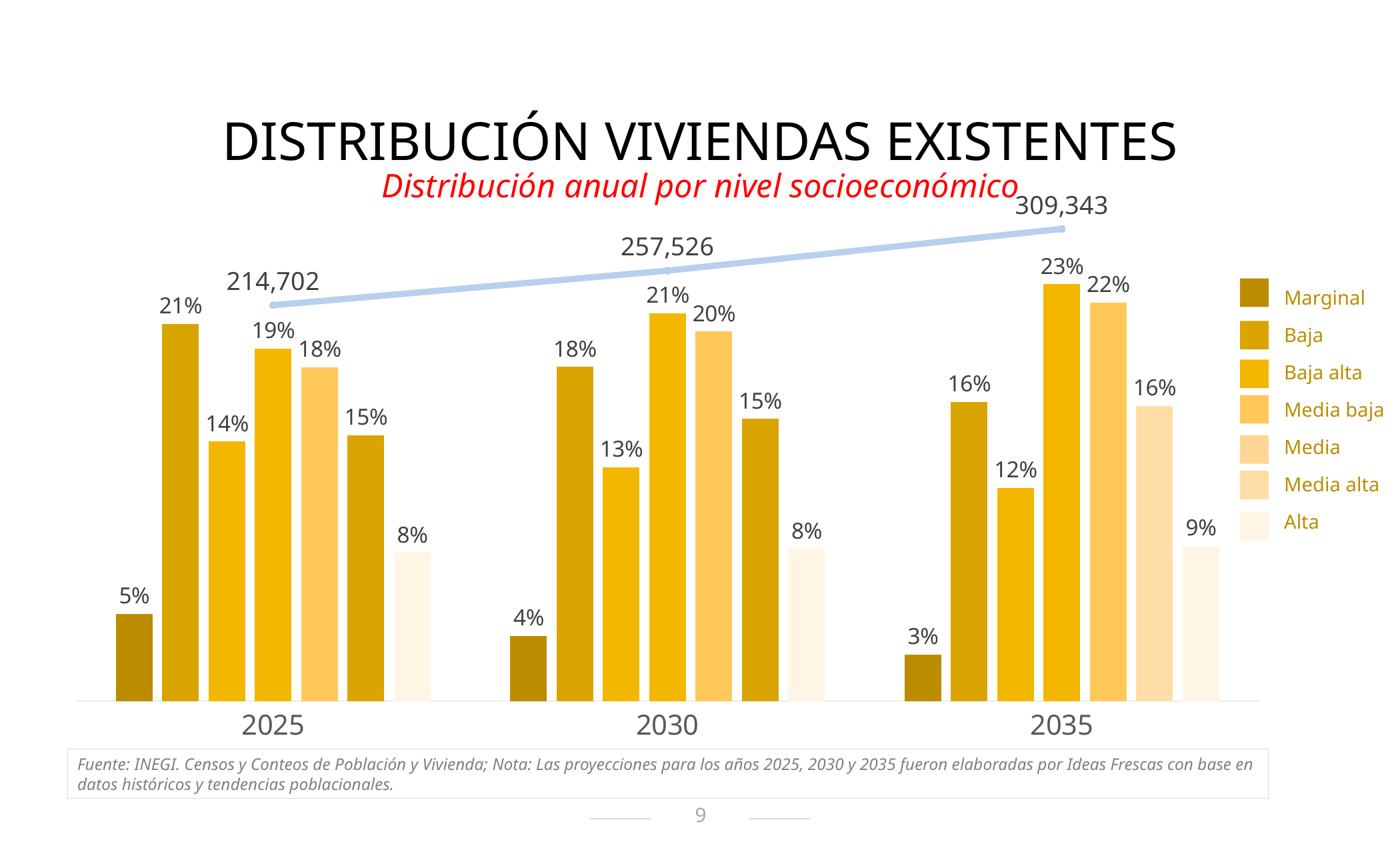
By how many percentage points does the Baja share fall from 2025 to 2035? 5 percentage points What is the value for Marginal in 2025? 5% How many series does the legend list? 7 Which socioeconomic level has the lowest share in 2030? Marginal Which socioeconomic level has the highest share in 2035? Media baja Does the Marginal share rise or fall from 2025 to 2035? Fall What is the value for Alta in 2035? 9% What total is shown on the line for 2030? 257,526 What kind of chart is used to show the socioeconomic distribution? Bar chart In 2030, which is larger: Media baja or Media? Media baja How many year groups are shown on the x axis? 3 What is the difference between the line totals for 2035 and 2025? 94,641